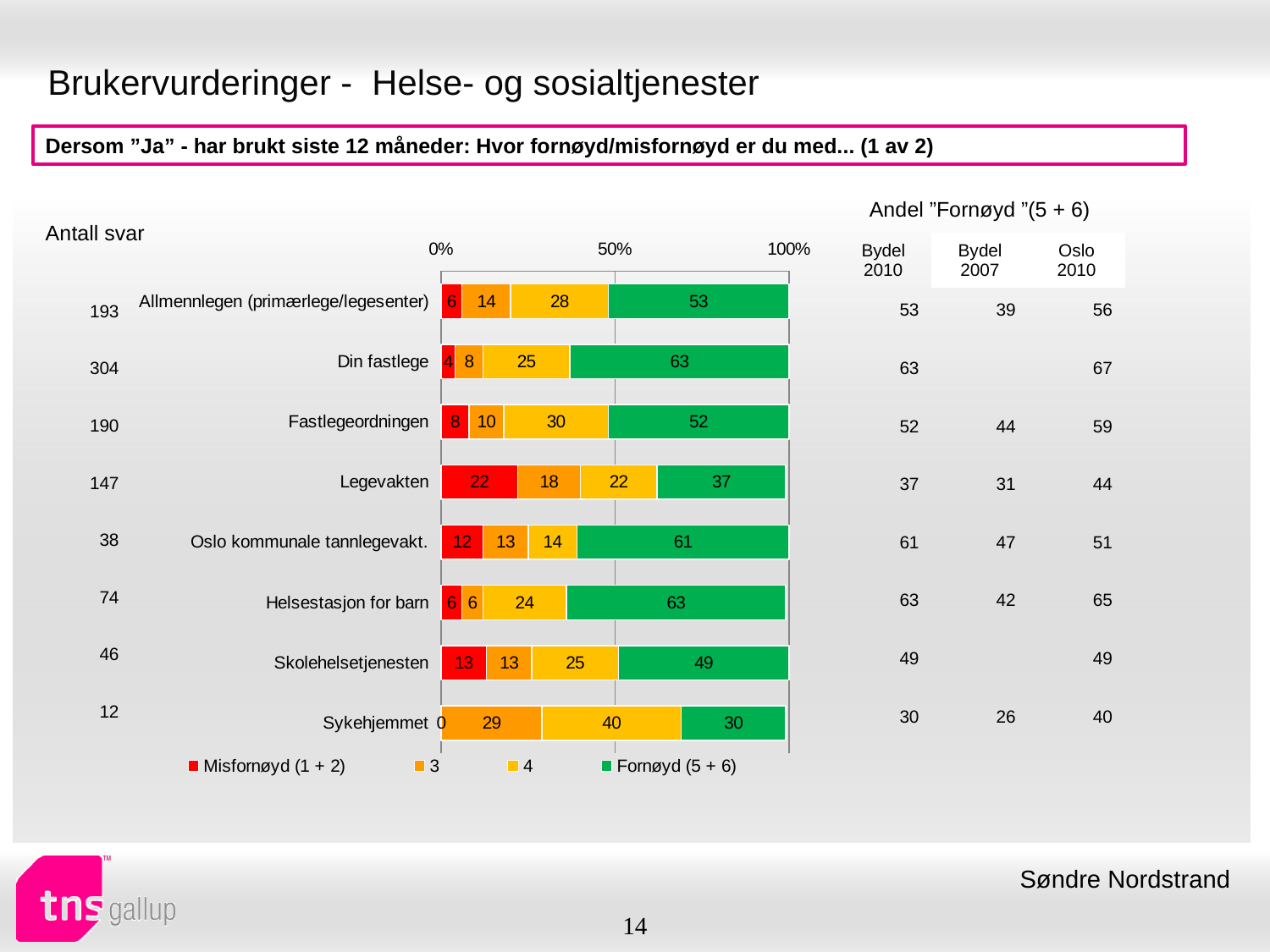
What is the value of the '3' segment for Fastlegeordningen? 10 How many categories are shown in the bar chart? 8 Which has a larger Fornøyd (5 + 6) value, Oslo kommunale tannlegevakt. or Skolehelsetjenesten? Oslo kommunale tannlegevakt. What is the value of the Fornøyd (5 + 6) segment for Allmennlegen (primærlege/legesenter)? 53 What colour represents the Fornøyd (5 + 6) series in the legend? Green Which category has the highest Misfornøyd (1 + 2) value? Legevakten What kind of chart is shown on the slide? Stacked bar chart Which category has the lowest Fornøyd (5 + 6) value? Sykehjemmet What is the value of the '4' segment for Sykehjemmet? 40 What is the difference between the Fornøyd (5 + 6) values for Allmennlegen (primærlege/legesenter) and Legevakten? 16 What is the value of the Misfornøyd (1 + 2) segment for Legevakten? 22 How many series does the legend list? 4